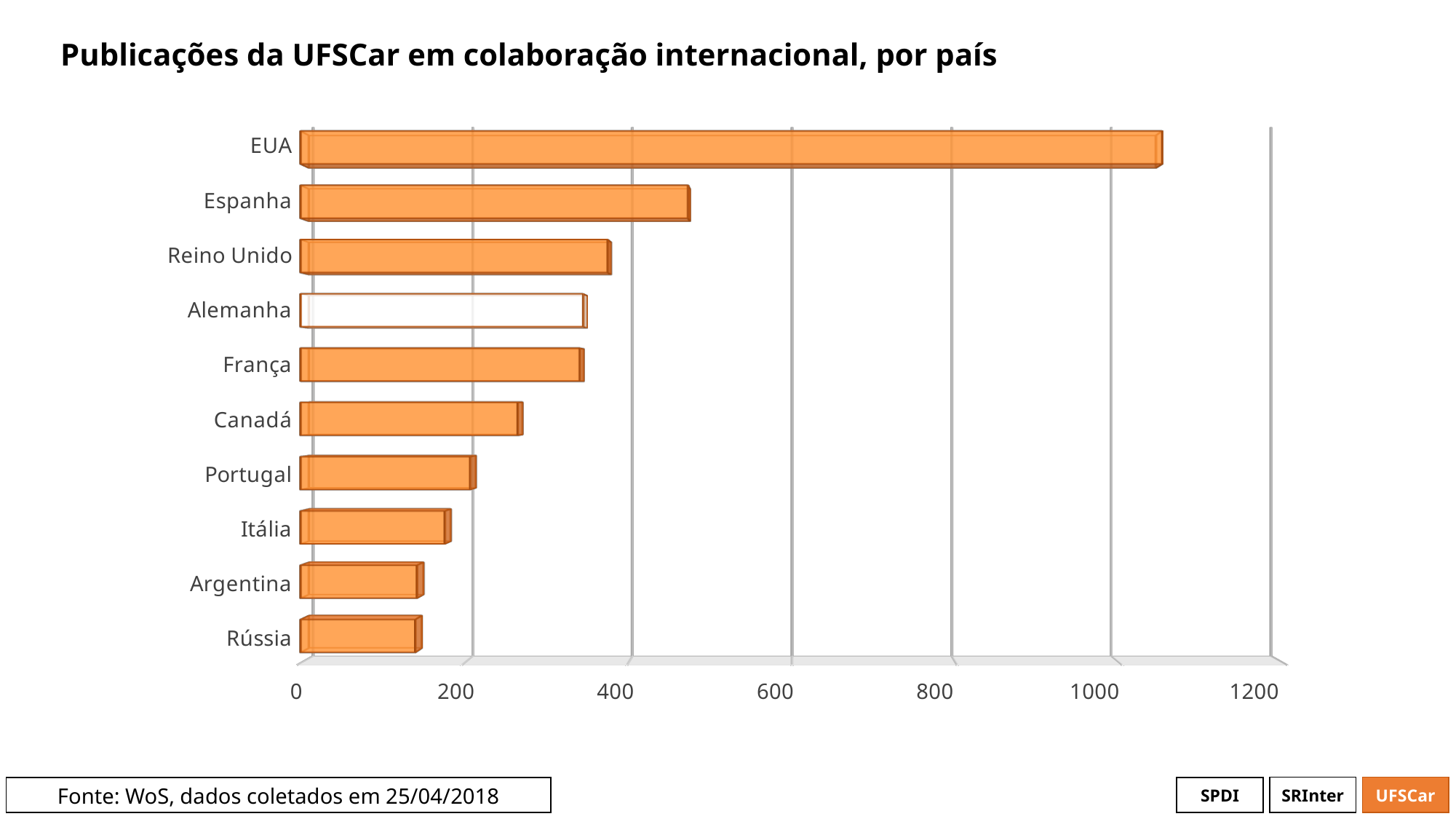
How many countries are shown in the chart? 10 Is the value for Rússia greater or less than 200? less Is the value for EUA greater or less than 1000? greater Is the value for Itália greater or less than 200? less Which has a larger value, Espanha or Reino Unido? Espanha Which country has the highest number of publications in international collaboration? EUA What is the title of the chart? Publicações da UFSCar em colaboração internacional, por país What kind of chart is shown on the slide? bar chart Which has a larger value, Canadá or Portugal? Canadá